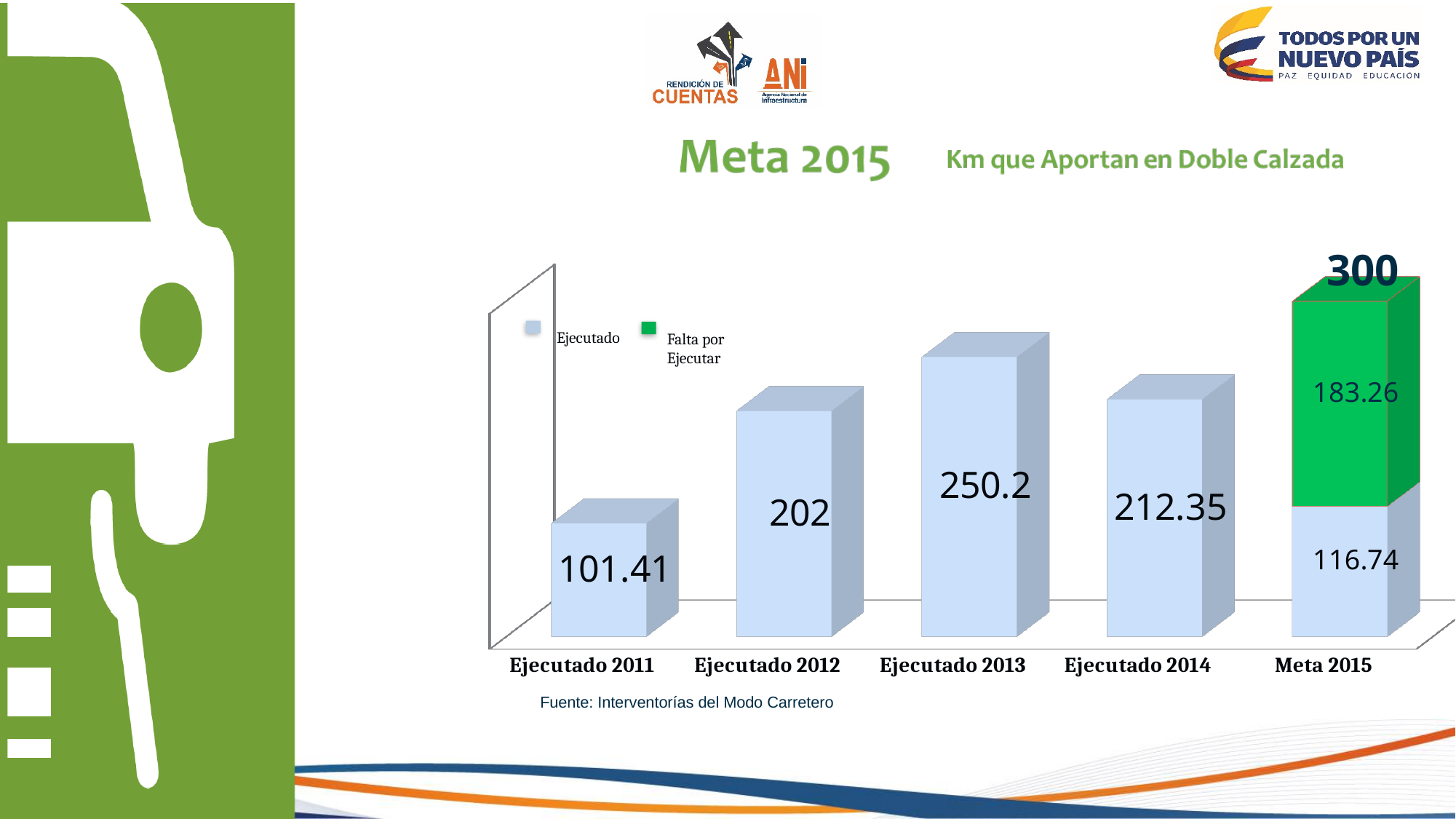
What kind of chart is shown on the slide? Bar chart Which category has the highest Ejecutado value? Ejecutado 2013 What is the Ejecutado value for Ejecutado 2013? 250.2 What is the Ejecutado value for Ejecutado 2011? 101.41 Which is larger, the Ejecutado value for Ejecutado 2012 or for Ejecutado 2014? Ejecutado 2014 Which category has the lowest Ejecutado value? Ejecutado 2011 What is the difference between the Ejecutado values for Ejecutado 2013 and Ejecutado 2014? 37.85 What is the Ejecutado value for Meta 2015? 116.74 How many series does the legend list? 2 How many categories are shown on the x axis? 5 What is the Falta por Ejecutar value for Meta 2015? 183.26 What is the total of the stacked bar for Meta 2015? 300